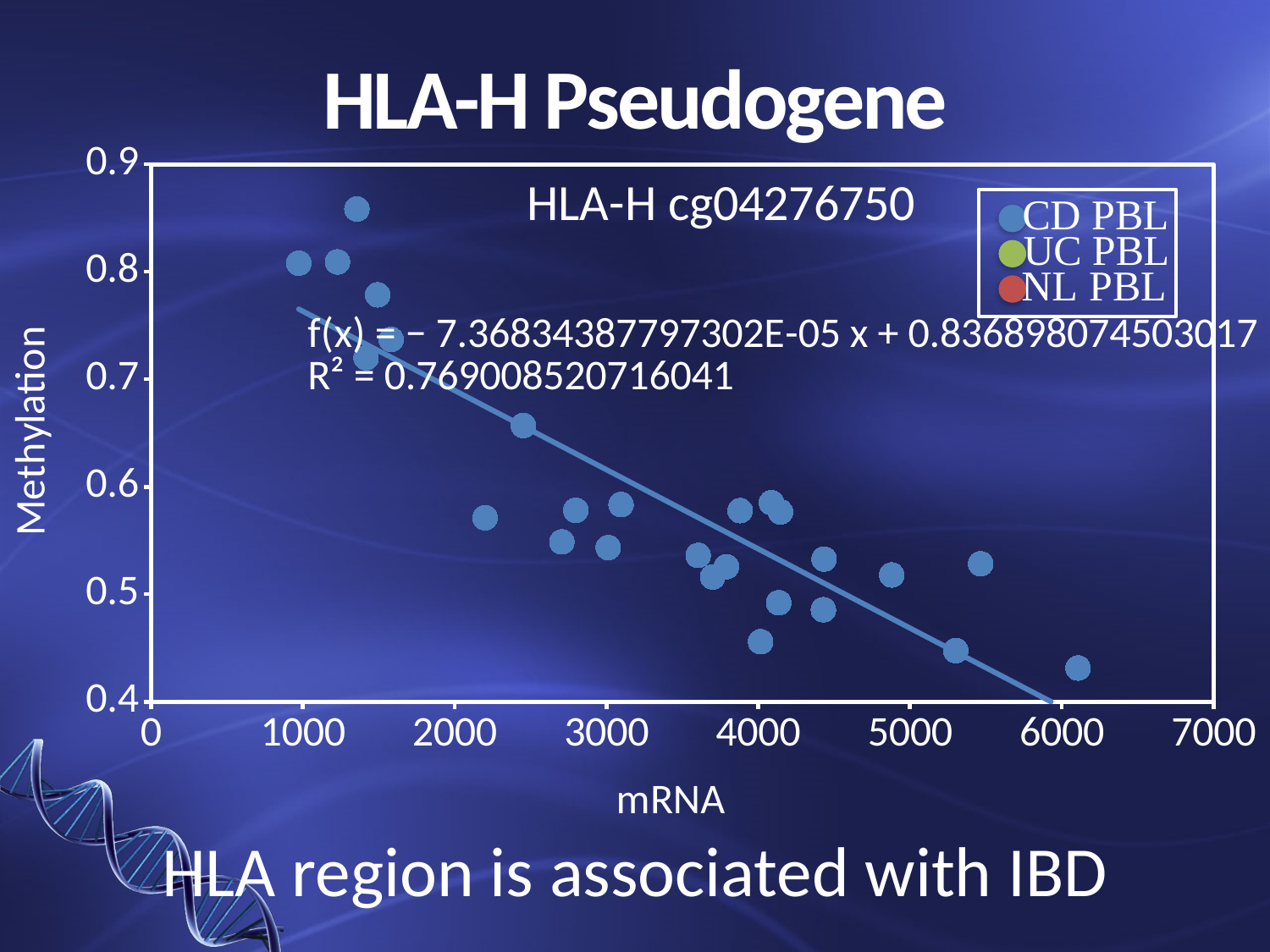
What is the title shown inside the chart area? HLA-H cg04276750 Is the methylation value of the point near mRNA 2450 greater or less than 0.6? greater What is the intercept in the trendline equation printed on the chart? 0.836898074503017 Is the methylation value of the lowest point near mRNA 4000 greater or less than 0.5? less Do the methylation values rise or fall as mRNA increases along the x axis? fall What kind of chart is shown on the slide? scatter chart What R² value is printed on the chart? 0.769008520716041 What is the label on the y axis of the chart? Methylation Is the methylation value of the point with the largest mRNA value (around 6000) greater or less than 0.5? less How many series does the legend list? 3 Which has the higher methylation: the point near mRNA 1400 at the top of the chart or the point near mRNA 6100 at the right? the point near mRNA 1400